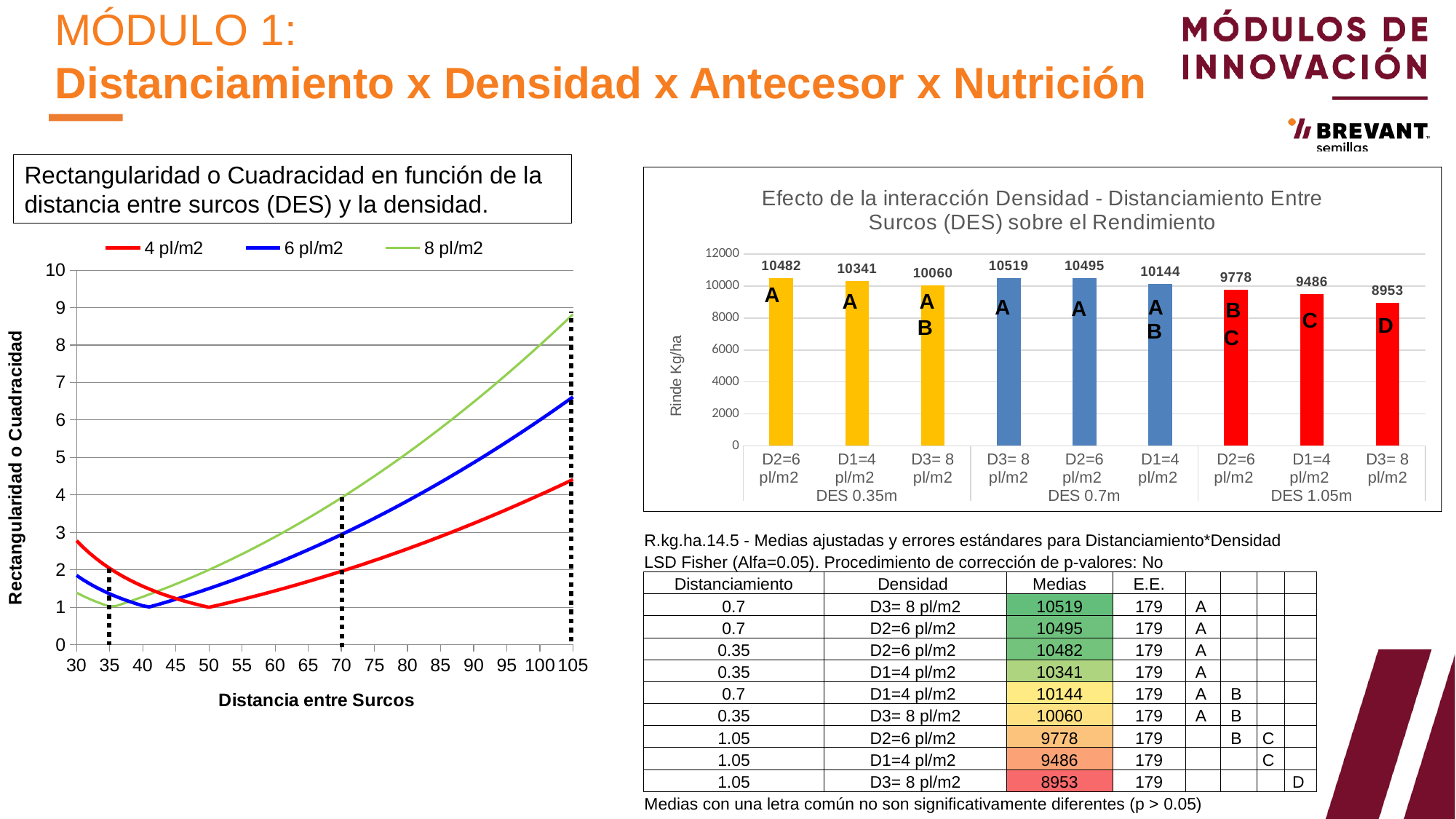
In the line chart on the left, is the value of the 8 pl/m2 series at a distance of 105 greater or less than 8? greater In the bar chart on the right, which is larger: D1=4 pl/m2 at DES 0.35m or D1=4 pl/m2 at DES 0.7m? D1=4 pl/m2 at DES 0.35m In the line chart on the left, does the 8 pl/m2 series rise or fall between a distance of 35 and 105? rise In the bar chart on the right, what is the difference between D2=6 pl/m2 at DES 0.35m and D2=6 pl/m2 at DES 1.05m? 704 In the bar chart on the right, which bar has the lowest value? D3= 8 pl/m2 at DES 1.05m In the bar chart on the right, which bar has the highest value? D3= 8 pl/m2 at DES 0.7m What is the y-axis label of the bar chart on the right? Rinde Kg/ha In the bar chart on the right, what is the value for D1=4 pl/m2 at DES 1.05m? 9486 What kind of chart is the chart on the left, 'Rectangularidad o Cuadracidad en función de la distancia entre surcos (DES) y la densidad'? line chart How many series does the legend of the line chart on the left list? 3 In the bar chart 'Efecto de la interacción Densidad - Distanciamiento Entre Surcos (DES) sobre el Rendimiento', what is the value for D3= 8 pl/m2 at DES 0.7m? 10519 How many bars are plotted in the bar chart on the right? 9